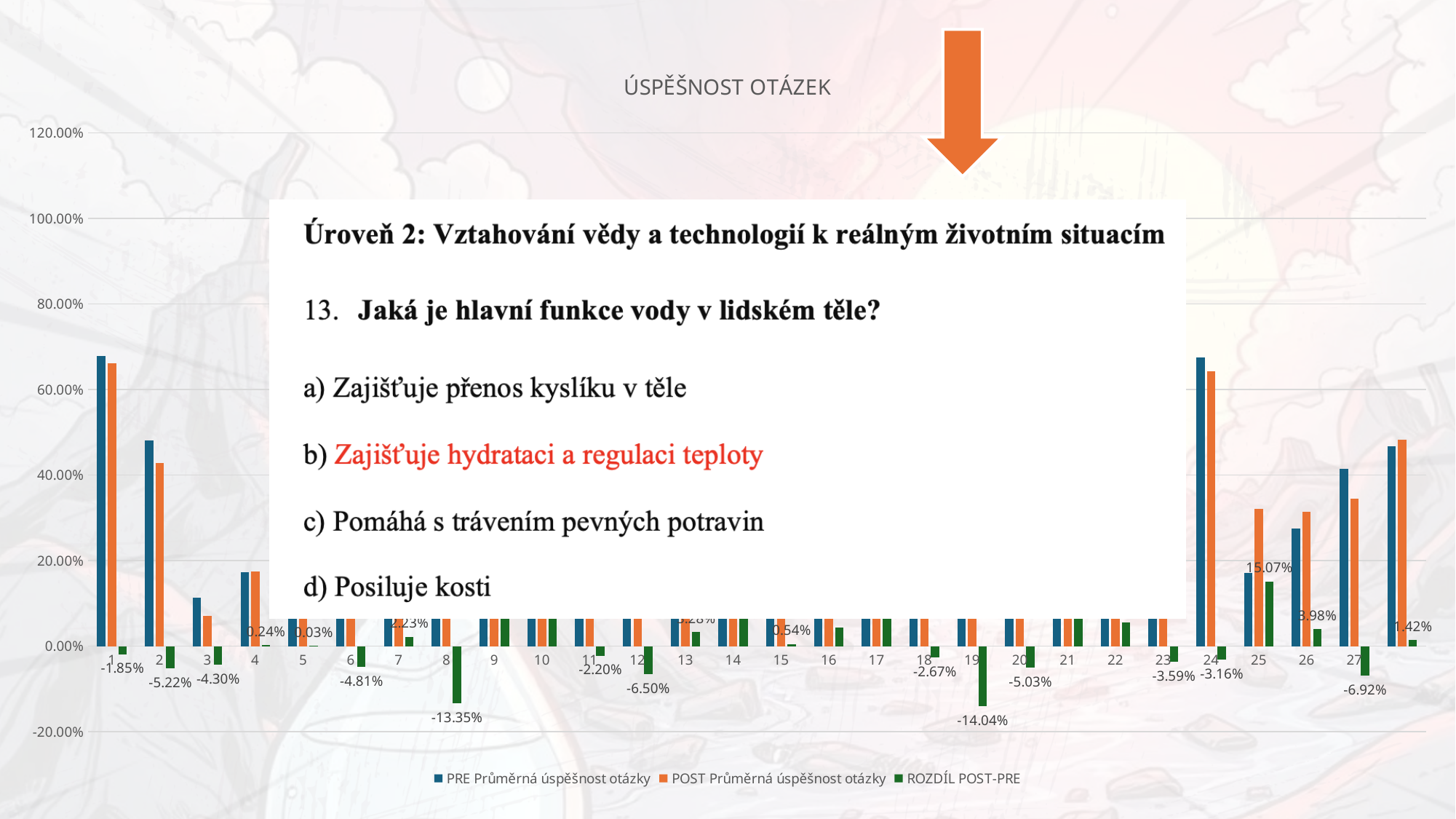
What is the ROZDÍL POST-PRE value for question 25? 15.07% What is the ROZDÍL POST-PRE value for question 8? -13.35% What is the difference between the ROZDÍL POST-PRE values for question 25 and question 26? 11.09% What kind of chart is shown on the slide? bar chart Which question has the lowest ROZDÍL POST-PRE value? 19 What is the title of the chart? ÚSPĚŠNOST OTÁZEK For question 25, which is larger: the PRE or the POST Průměrná úspěšnost otázky value? POST What is the ROZDÍL POST-PRE value for question 19? -14.04% Is the PRE Průměrná úspěšnost otázky value for question 1 greater or less than 60%? greater How many series does the chart's legend list? 3 Which series is shown in green in the chart? ROZDÍL POST-PRE